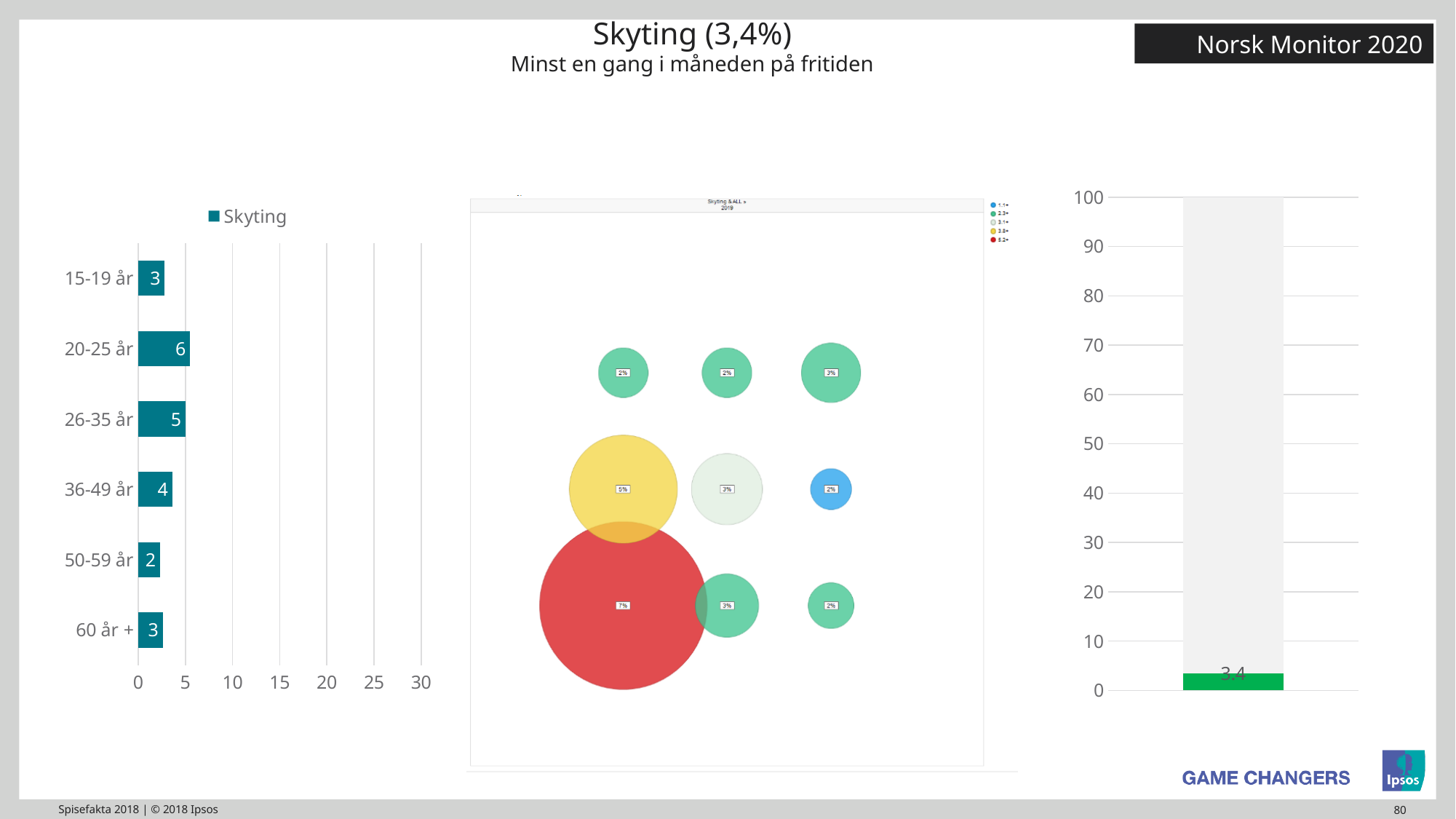
In the bar chart on the right of the slide, what value is printed on the bar? 3,4 In the left bar chart, what is the value for the 50-59 år age group? 2 How many age groups are shown in the left bar chart? 6 In the left bar chart, what is the difference between the values for 20-25 år and 36-49 år? 2 What kind of chart is the chart on the left of the slide? bar chart In the left bar chart, which is larger, the value for 26-35 år or the value for 60 år +? 26-35 år In the left bar chart, which age group has the highest value? 20-25 år In the left bar chart, what is the value for the 20-25 år age group? 6 In the bar chart on the right of the slide, is the value of the bar greater or less than 10? less What series name does the legend of the left bar chart show? Skyting In the bubble chart in the middle of the slide, what is the highest percentage printed on a bubble? 7% In the left bar chart, which age group has the lowest value? 50-59 år